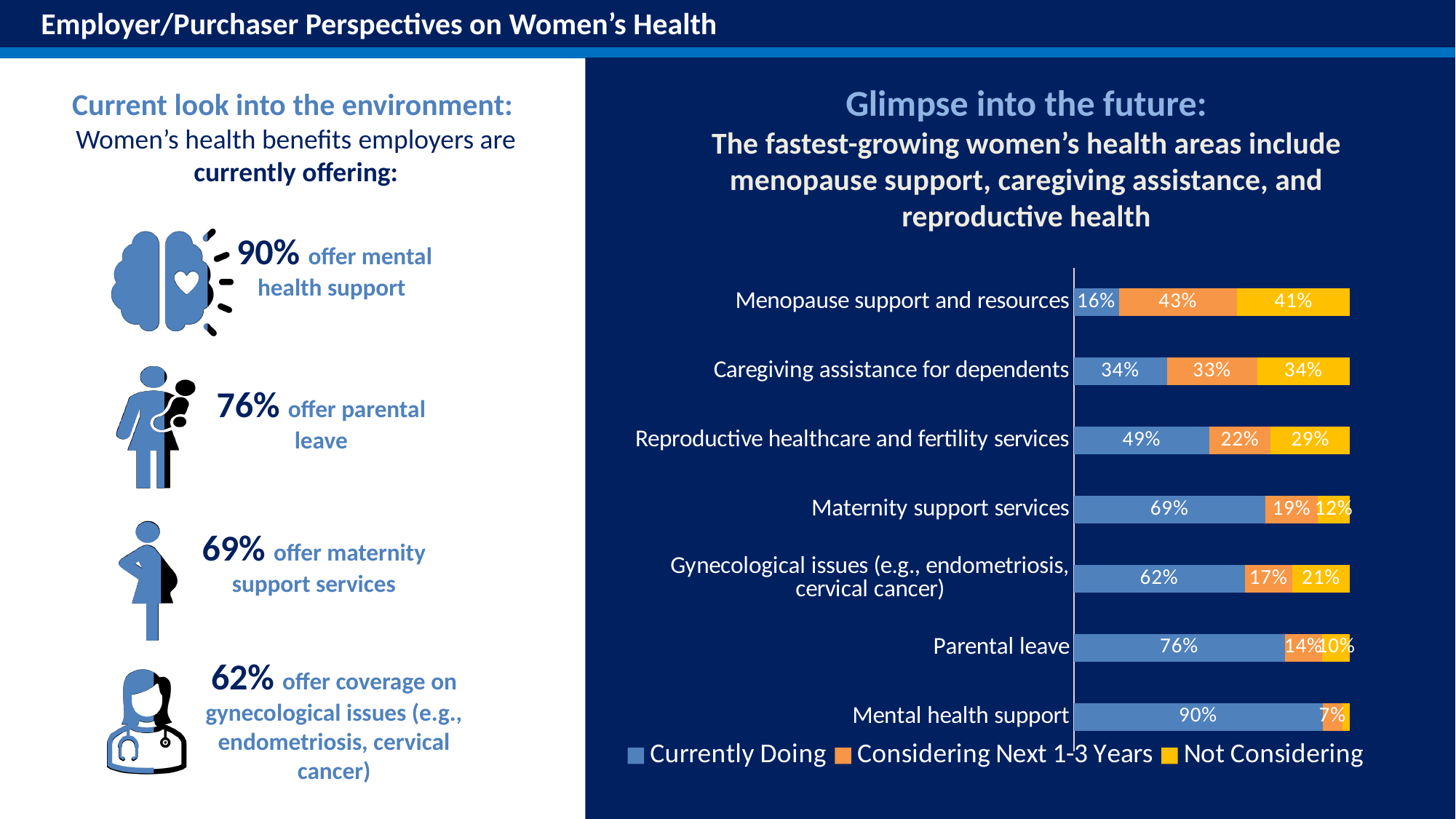
What kind of chart is shown on the slide? Stacked bar chart What are the three legend entries of the chart? Currently Doing, Considering Next 1-3 Years, Not Considering Which category has the lowest Currently Doing value? Menopause support and resources How many categories are shown in the bar chart? 7 What is the Considering Next 1-3 Years value for caregiving assistance for dependents? 33% What is the difference between the Currently Doing values for parental leave and maternity support services? 7 percentage points Which category has the highest Currently Doing value? Mental health support What is the Not Considering value for reproductive healthcare and fertility services? 29% Which has a larger Not Considering value: menopause support and resources or caregiving assistance for dependents? Menopause support and resources Which category has the highest Considering Next 1-3 Years value? Menopause support and resources What percentage of employers are Currently Doing menopause support and resources? 16% How many series does the legend list? 3